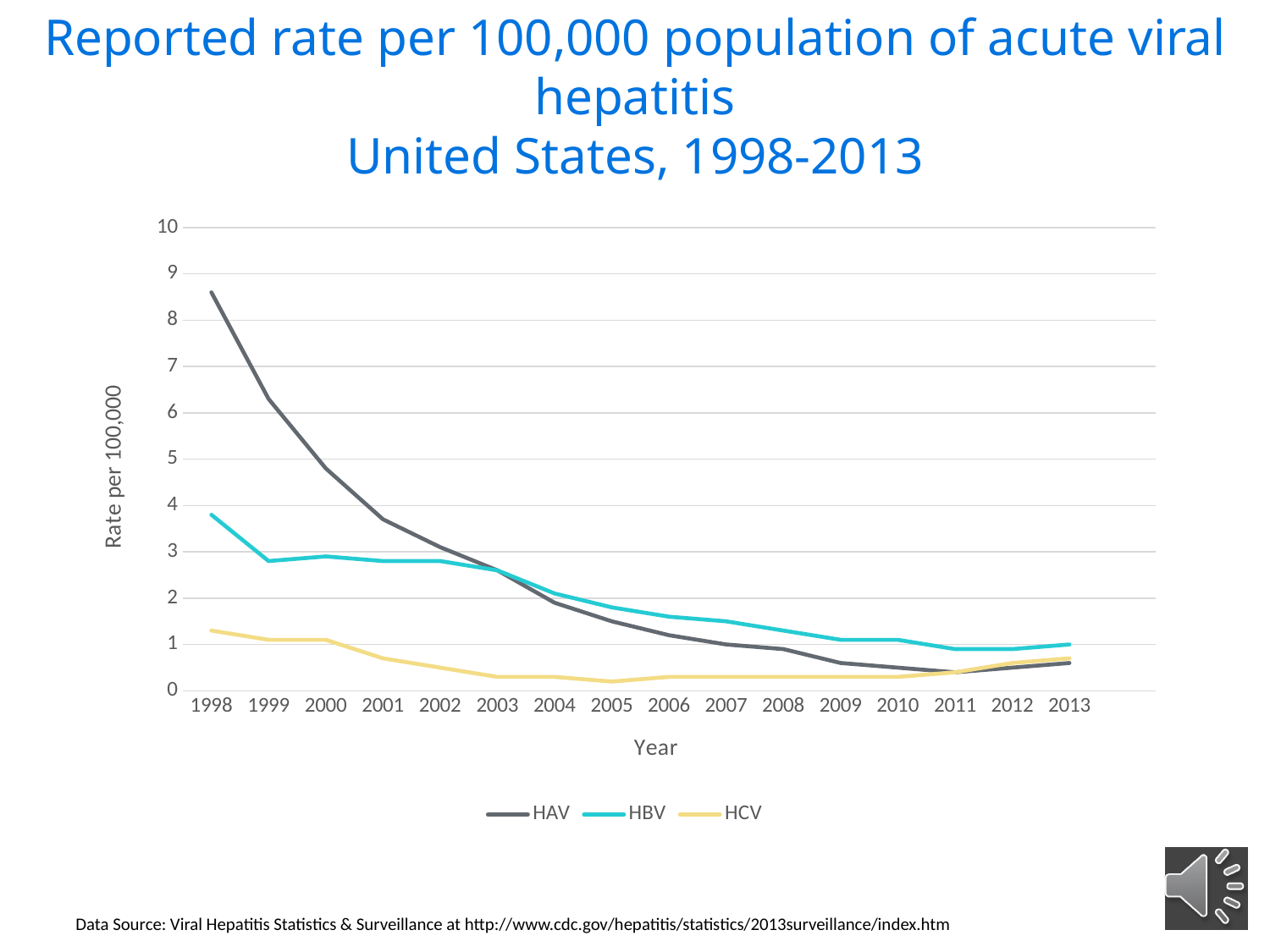
What kind of chart is shown on the slide? line chart How many series does the legend list? 3 Is the HCV value for 2005 greater or less than 1? less Is the HAV value for 1998 greater or less than 8? greater Is the HAV value for 2001 greater or less than 3? greater How many years are plotted along the x axis? 16 What is the label of the y axis? Rate per 100,000 In 1998, which series has the highest rate? HAV In 1998, which series has the lowest rate? HCV In 2008, which is larger, the HAV rate or the HBV rate? HBV Does the HAV rate rise or fall from 1998 to 2013? fall